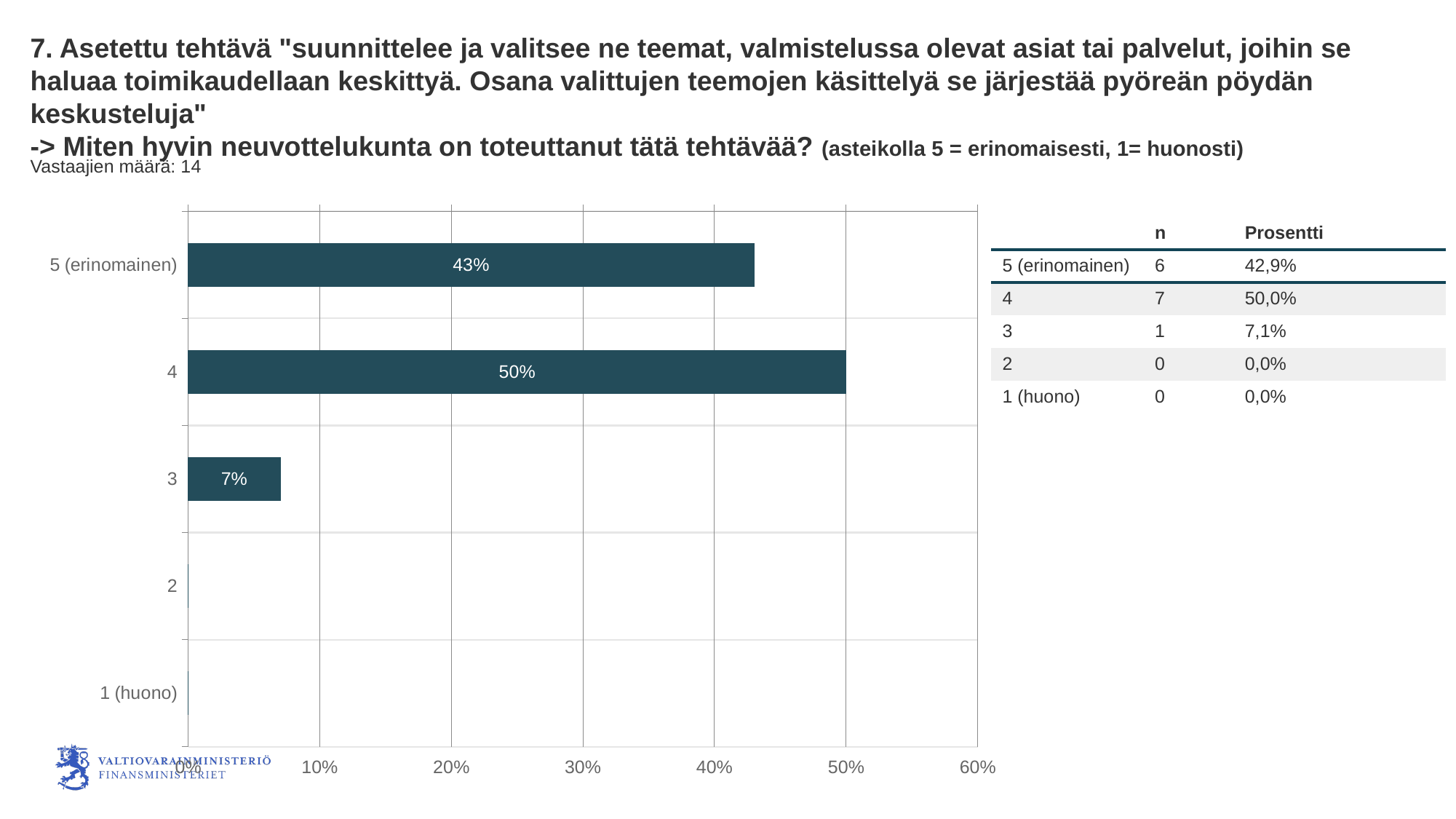
Is the value for "5 (erinomainen)" greater or less than 40%? greater What kind of chart is shown on the slide? bar chart Which category has the lowest non-zero value? 3 What is the difference between the values for "4" and "5 (erinomainen)"? 7% What is the value shown for the category "4"? 50% What is the value shown for the category "3"? 7% Which category has the highest value? 4 Which is larger, the value for "5 (erinomainen)" or the value for "3"? 5 (erinomainen) How many categories are shown on the chart's vertical axis? 5 What is the highest value shown on the horizontal axis? 60% What is the value shown for "5 (erinomainen)"? 43% How many respondents (Vastaajien määrä) are stated on the slide? 14